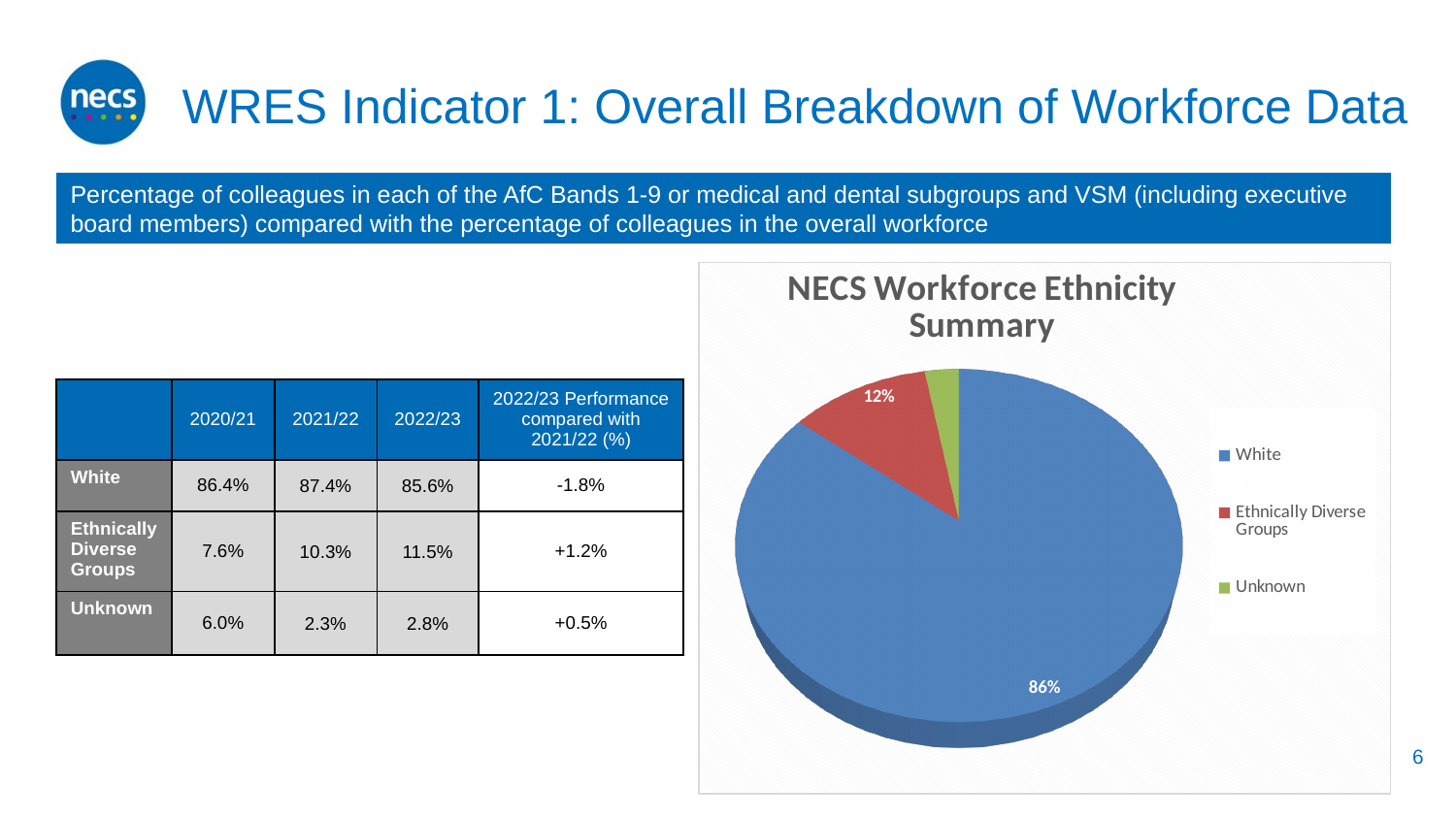
In the pie chart, which is larger: the White slice or the Ethnically Diverse Groups slice? White How many categories are shown in the NECS Workforce Ethnicity Summary pie chart? 3 What is the title of the pie chart? NECS Workforce Ethnicity Summary What colour is the Unknown slice in the NECS Workforce Ethnicity Summary pie chart? green Which category has the smallest slice in the NECS Workforce Ethnicity Summary pie chart? Unknown In the NECS Workforce Ethnicity Summary pie chart, what share of the workforce is in Ethnically Diverse Groups? 12% In the NECS Workforce Ethnicity Summary pie chart, what share of the workforce is White? 86% What is the difference in percentage points between the White slice and the Ethnically Diverse Groups slice in the pie chart? 74 What kind of chart is shown on the slide? pie chart Which category has the largest slice in the NECS Workforce Ethnicity Summary pie chart? White How many entries does the legend of the pie chart list? 3